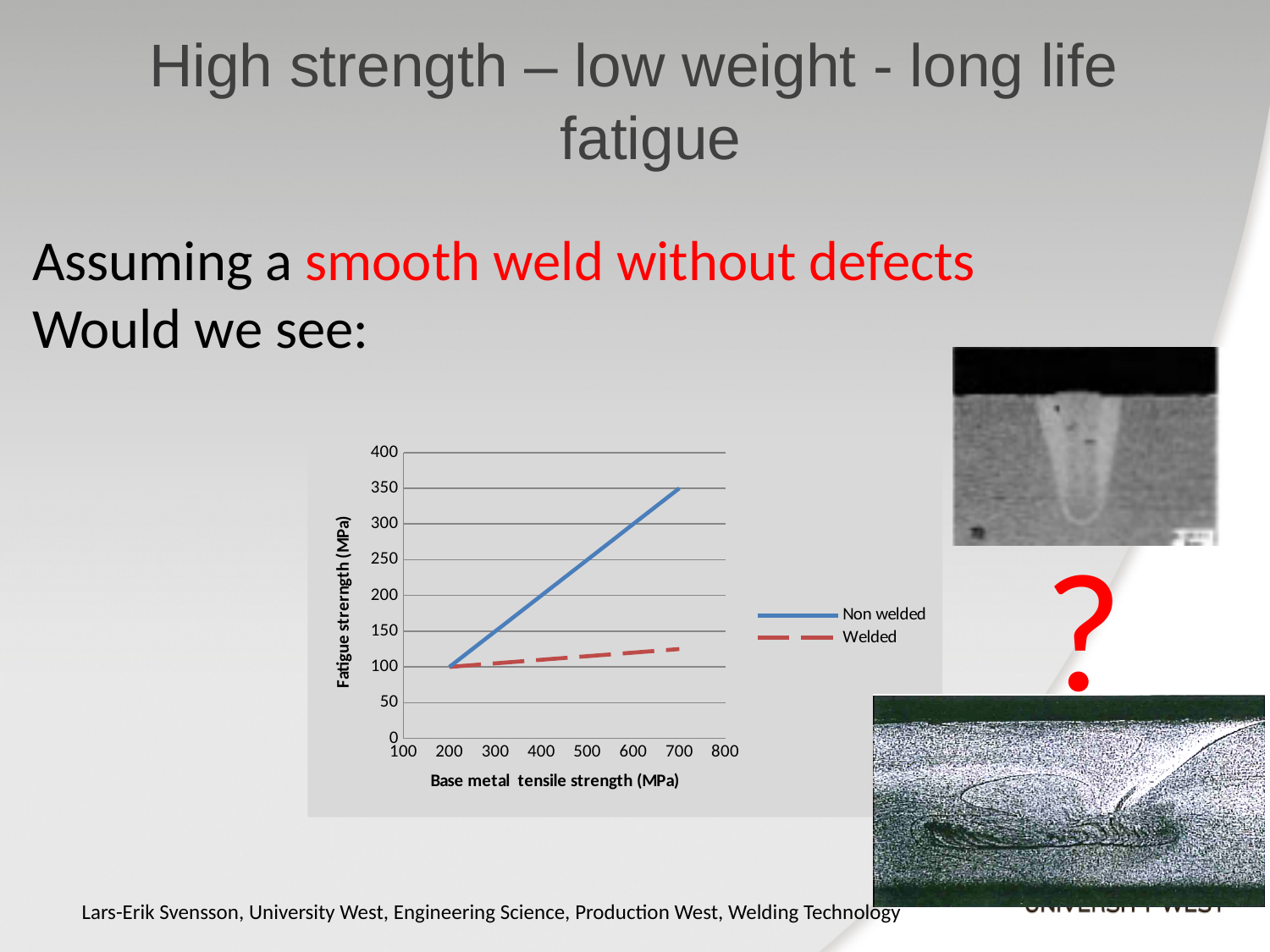
At a base metal tensile strength of 700 MPa, which series has the higher fatigue strength, Non welded or Welded? Non welded What is the fatigue strength of the Non welded series at a base metal tensile strength of 200 MPa? 100 Does the Welded line rise or fall as base metal tensile strength increases? rise Which series reaches the highest fatigue strength on the chart? Non welded What are the two series named in the chart legend? Non welded and Welded What is the fatigue strength of the Non welded series at a base metal tensile strength of 700 MPa? 350 What is the title of the chart's vertical axis? Fatigue strerngth (MPa) What kind of chart is shown on the slide? line chart How many series does the chart legend list? 2 Does the Non welded line rise or fall as base metal tensile strength increases? rise Is the fatigue strength of the Welded series at 700 MPa base metal tensile strength greater or less than 150? less Is the fatigue strength of the Non welded series at 500 MPa base metal tensile strength greater or less than 200? greater